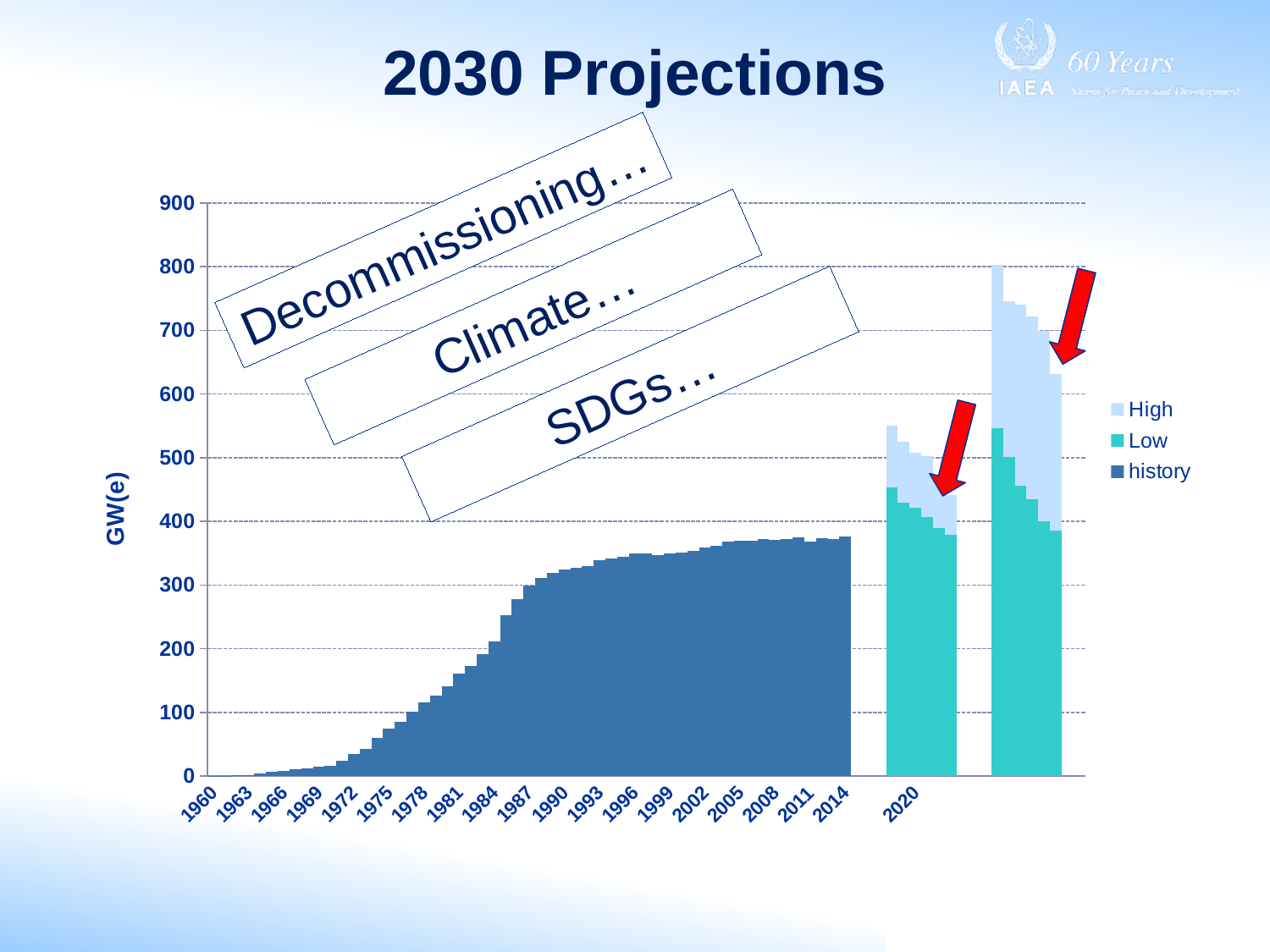
Is the history value for 2014 greater or less than 400? less What kind of chart is shown on the slide? bar chart Is the tallest High bar in the 2020 group greater or less than 500? greater How many series does the legend list? 3 Is the history value for 1975 greater or less than 100? less Which series is drawn in dark blue according to the legend? history What is the label on the vertical axis? GW(e) Does the history series rise or fall from 1960 to 2014? rise Which is larger: the tallest High bar in the 2020 group or the history value for 2014? the tallest High bar in the 2020 group